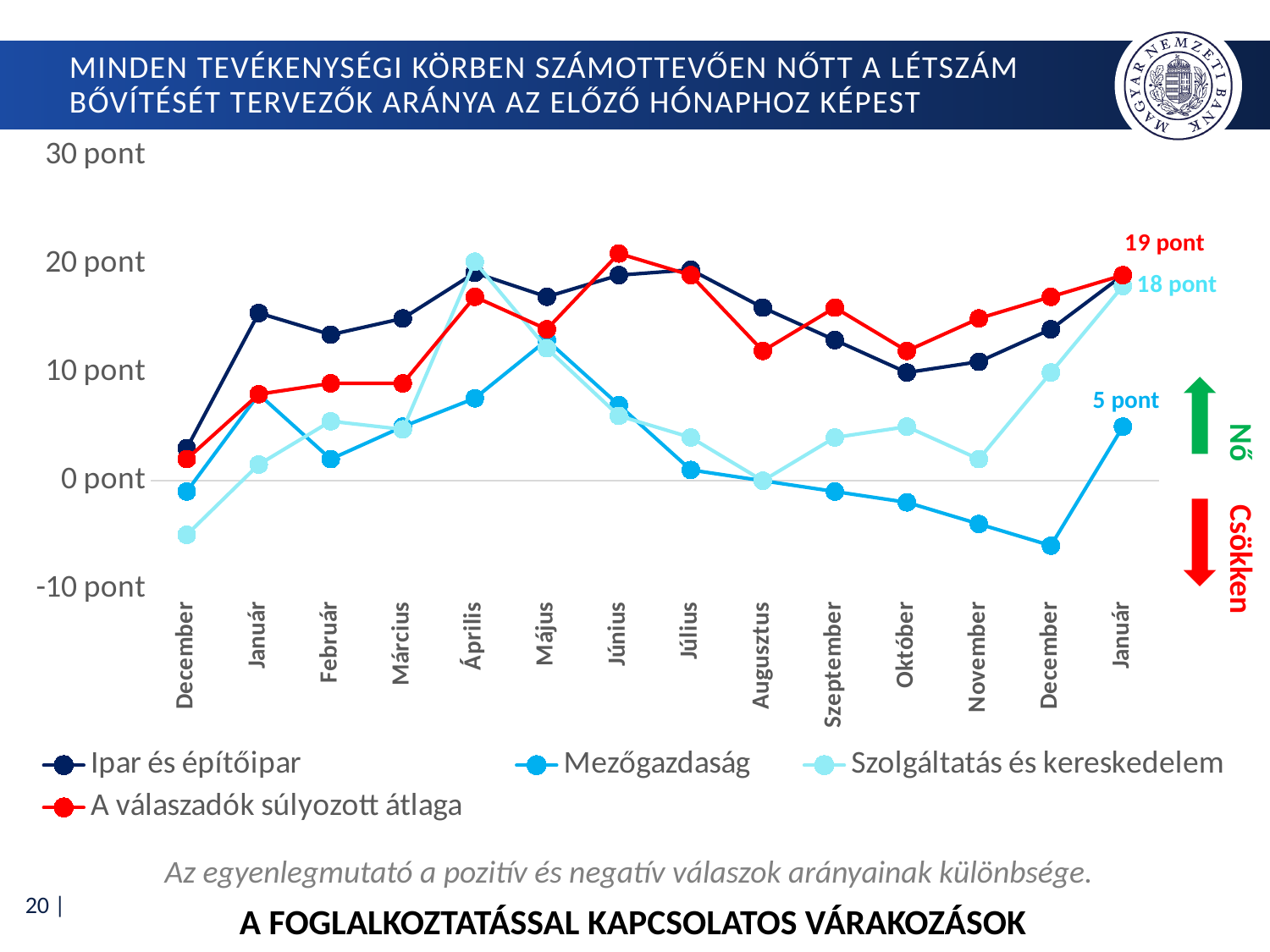
What is the value of Mezőgazdaság in the final Január? 5 pont In the final Január, what is the difference between A válaszadók súlyozott átlaga and Mezőgazdaság? 14 pont Is the value for Mezőgazdaság in the second December (the one before the final Január) greater or less than 0 pont? less Does the Mezőgazdaság line rise or fall from Május to the second December? fall What is the value of Szolgáltatás és kereskedelem in the final Január? 18 pont What is the value of A válaszadók súlyozott átlaga in the final Január? 19 pont In the final Január, which is larger: Szolgáltatás és kereskedelem or Mezőgazdaság? Szolgáltatás és kereskedelem In which month does Mezőgazdaság reach its highest value? Május How many series does the legend list? 4 How many months are shown on the x axis? 14 Is the value for Ipar és építőipar in Április greater or less than 10 pont? greater What kind of chart is shown on the slide? line chart